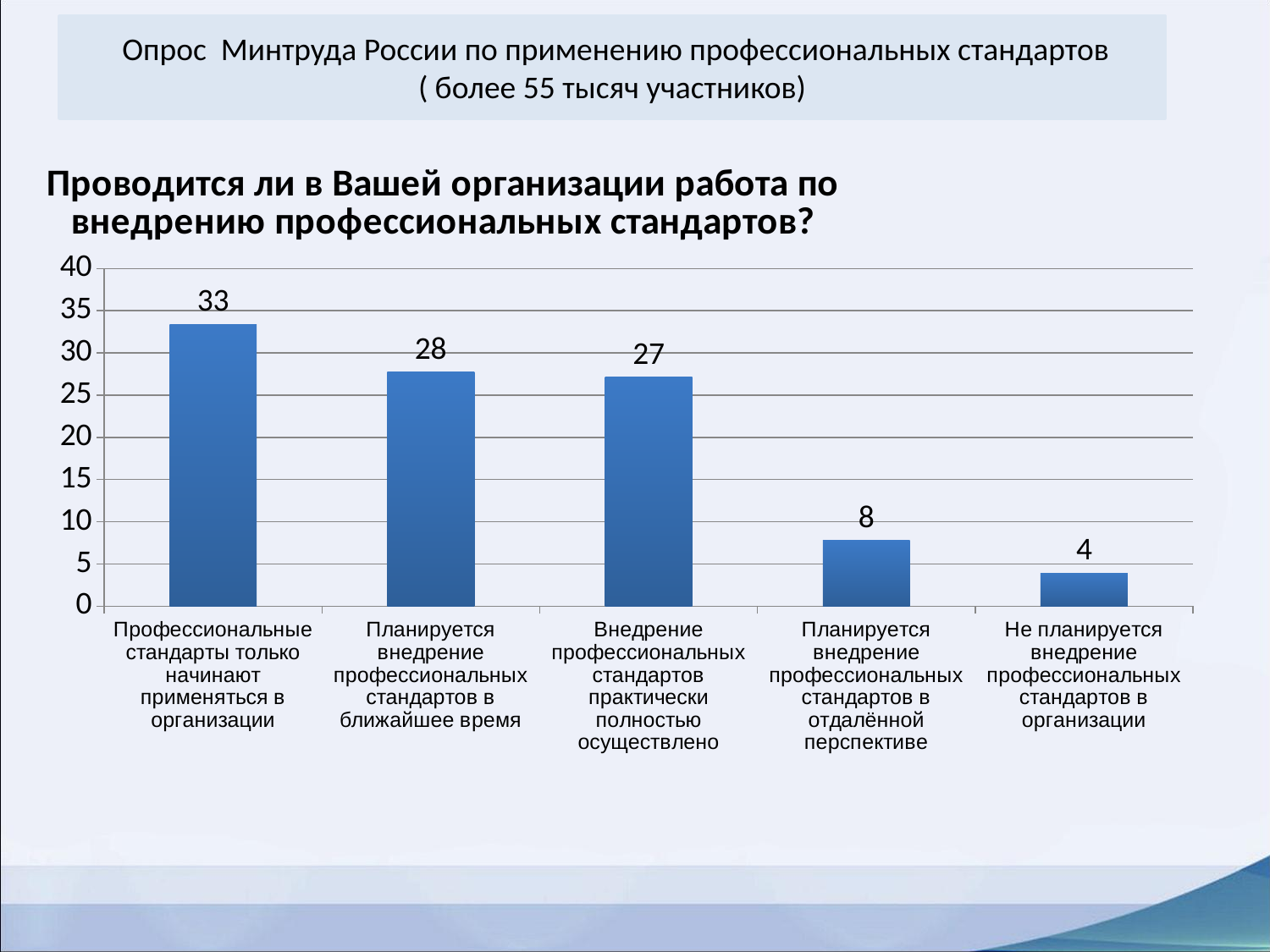
Which category has the lowest value? Не планируется внедрение профессиональных стандартов в организации What is the value for 'Планируется внедрение профессиональных стандартов в отдалённой перспективе'? 8 Which is larger: the value for 'Планируется внедрение профессиональных стандартов в отдалённой перспективе' or for 'Не планируется внедрение профессиональных стандартов в организации'? Планируется внедрение профессиональных стандартов в отдалённой перспективе What is the value for 'Не планируется внедрение профессиональных стандартов в организации'? 4 How many categories are shown on the chart? 5 Is the value for 'Внедрение профессиональных стандартов практически полностью осуществлено' greater or less than 25? greater What is the difference between the highest and lowest values on the chart? 29 What kind of chart is shown on the slide? Bar chart What is the difference between the values for 'Планируется внедрение профессиональных стандартов в ближайшее время' and 'Внедрение профессиональных стандартов практически полностью осуществлено'? 1 Do the values rise or fall from left to right across the categories? Fall What is the value for 'Профессиональные стандарты только начинают применяться в организации'? 33 Which category has the highest value? Профессиональные стандарты только начинают применяться в организации